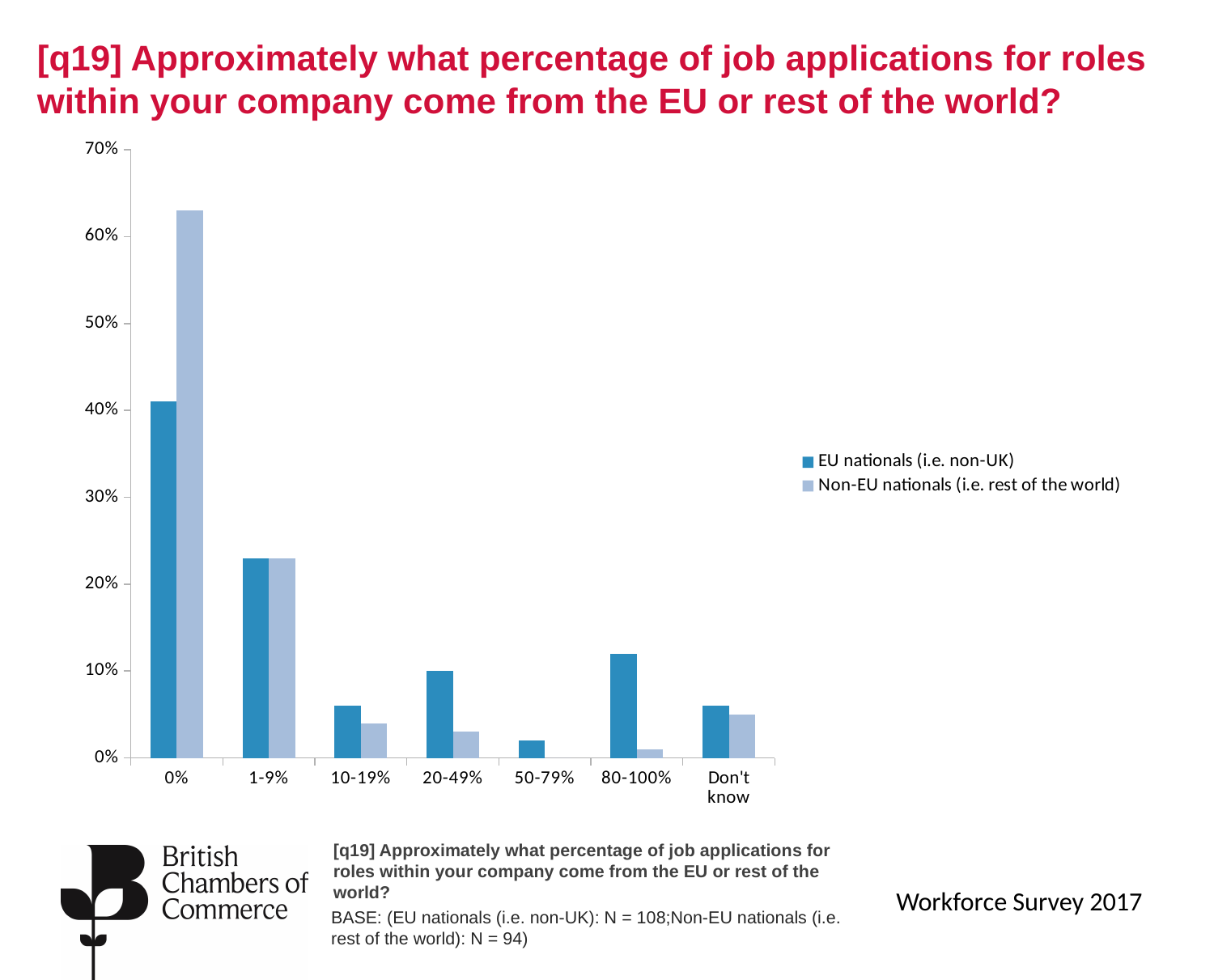
Is the value for EU nationals (i.e. non-UK) in the 0% category greater or less than 50%? less In the 80-100% category, which series has the larger value: EU nationals (i.e. non-UK) or Non-EU nationals (i.e. rest of the world)? EU nationals (i.e. non-UK) How many series does the legend list? 2 Which category has the lowest value for EU nationals (i.e. non-UK)? 50-79% What is the highest value shown on the y axis? 70% Which category has the highest value for EU nationals (i.e. non-UK)? 0% What kind of chart is shown on the slide? bar chart In the 0% category, which series has the larger value: EU nationals (i.e. non-UK) or Non-EU nationals (i.e. rest of the world)? Non-EU nationals (i.e. rest of the world) How many categories are shown on the x axis? 7 Which category has the highest value for Non-EU nationals (i.e. rest of the world)? 0% Is the value for EU nationals (i.e. non-UK) in the 1-9% category greater or less than 20%? greater Is the value for Non-EU nationals (i.e. rest of the world) in the 0% category greater or less than 60%? greater